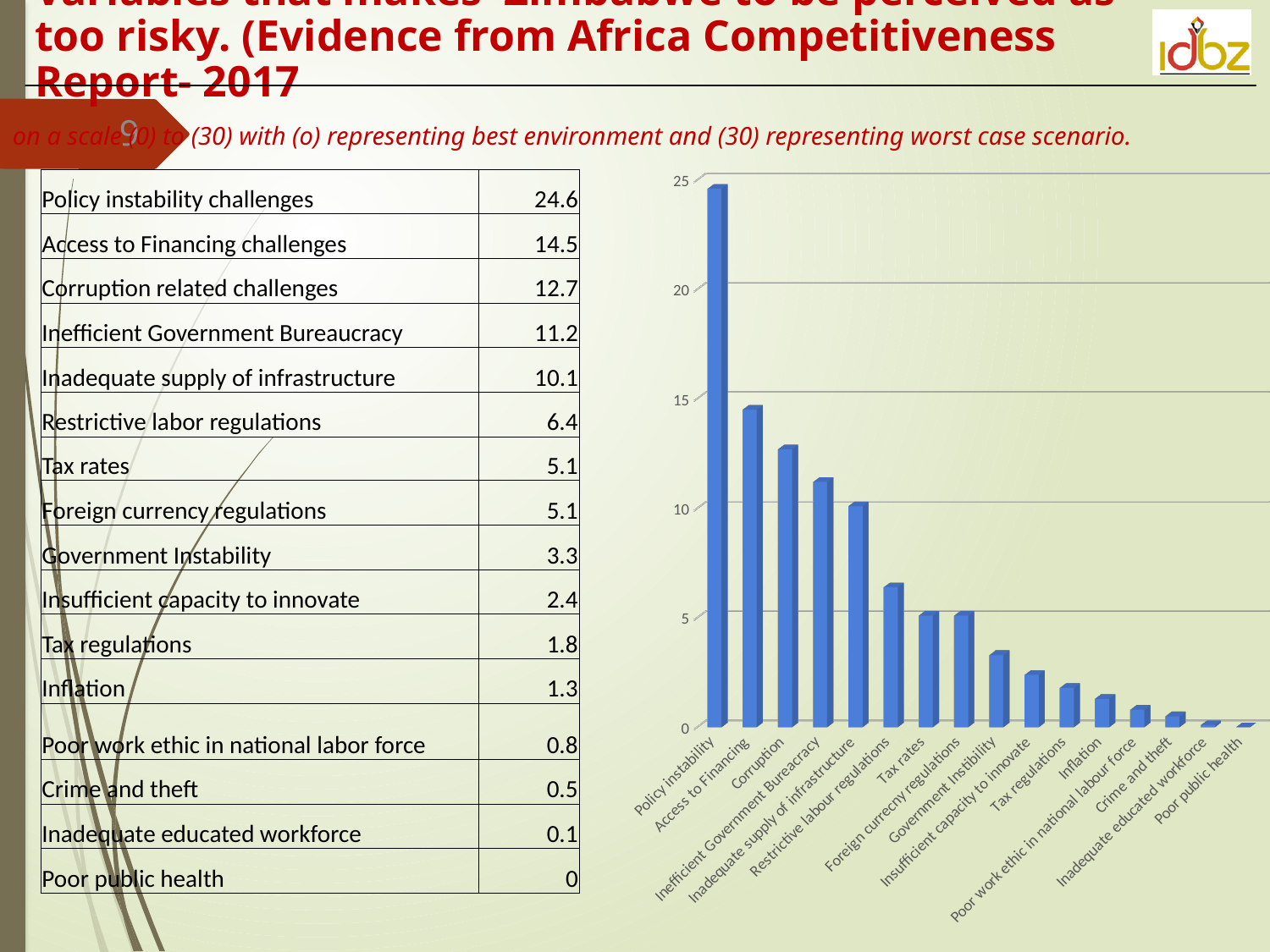
What type of chart is shown on the slide? bar chart What is the value for Policy instability challenges? 24.6 What is the difference between the values for Policy instability challenges and Access to Financing challenges? 10.1 What is the difference between the values for Tax rates and Tax regulations? 3.3 Is the value for Inadequate supply of infrastructure greater or less than 10? greater Which is larger, the value for Restrictive labor regulations or the value for Government Instability? Restrictive labor regulations Which category has the highest value in the chart? Policy instability Which category has the lowest value in the chart? Poor public health Do the values rise or fall moving from left to right along the x axis? fall How many categories are plotted in the bar chart? 16 What is the value for Inflation? 1.3 What is the value for Corruption related challenges? 12.7